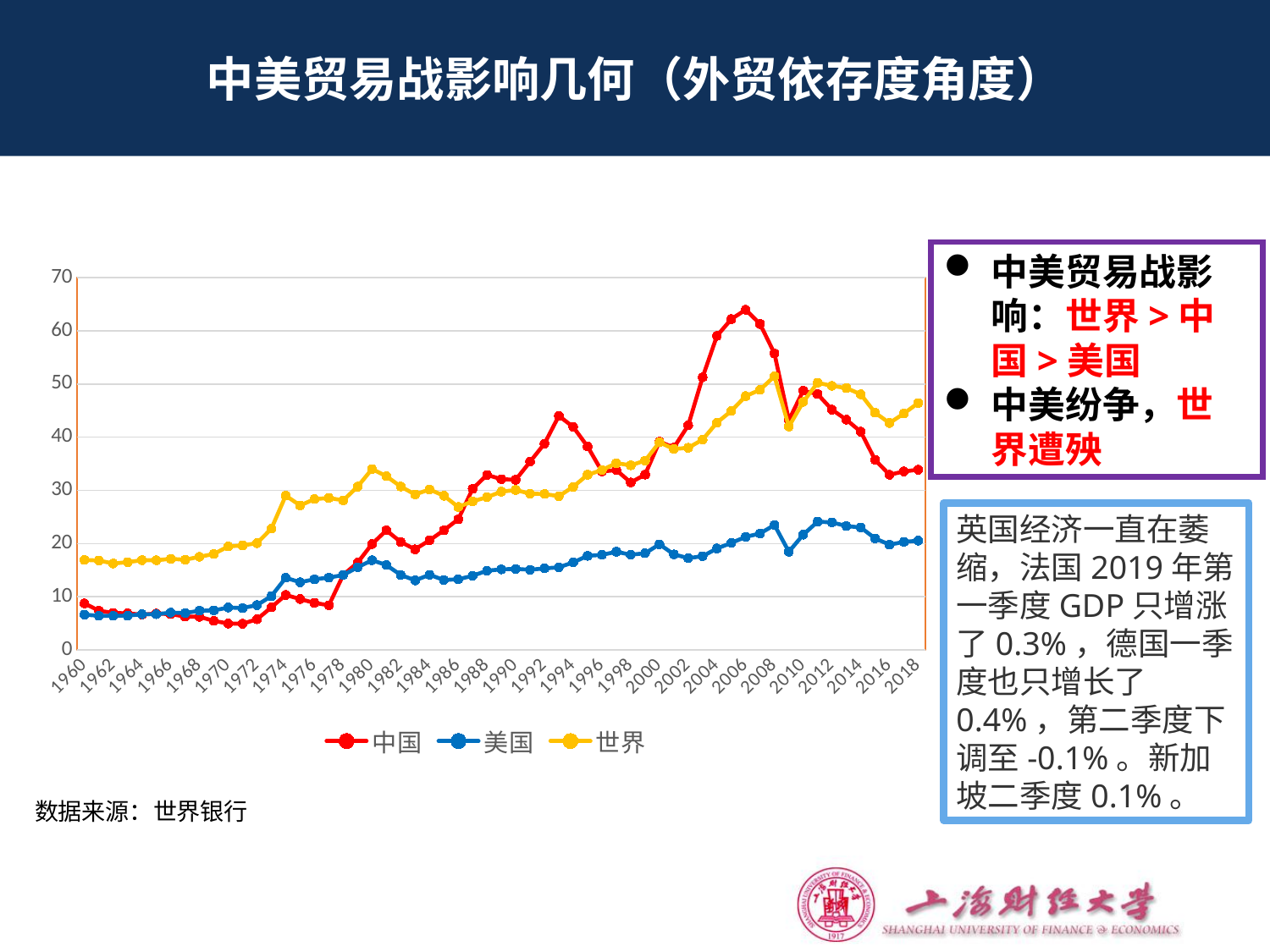
How many series does the legend list? 3 Which series has the lowest value in 2018? 美国 Does the 美国 series generally rise or fall from 1960 to 2018? rise Is the value for 中国 in 1970 greater or less than 10? less Is the value for 美国 in 2018 greater or less than 30? less Is the value for 世界 in 1960 greater or less than 20? less In 2018, which is higher, 中国 or 美国? 中国 Which series has the highest value in 2006? 中国 In 2018, which is higher, 世界 or 中国? 世界 What kind of chart is shown on the slide? line chart What are the three series named in the legend? 中国, 美国, 世界